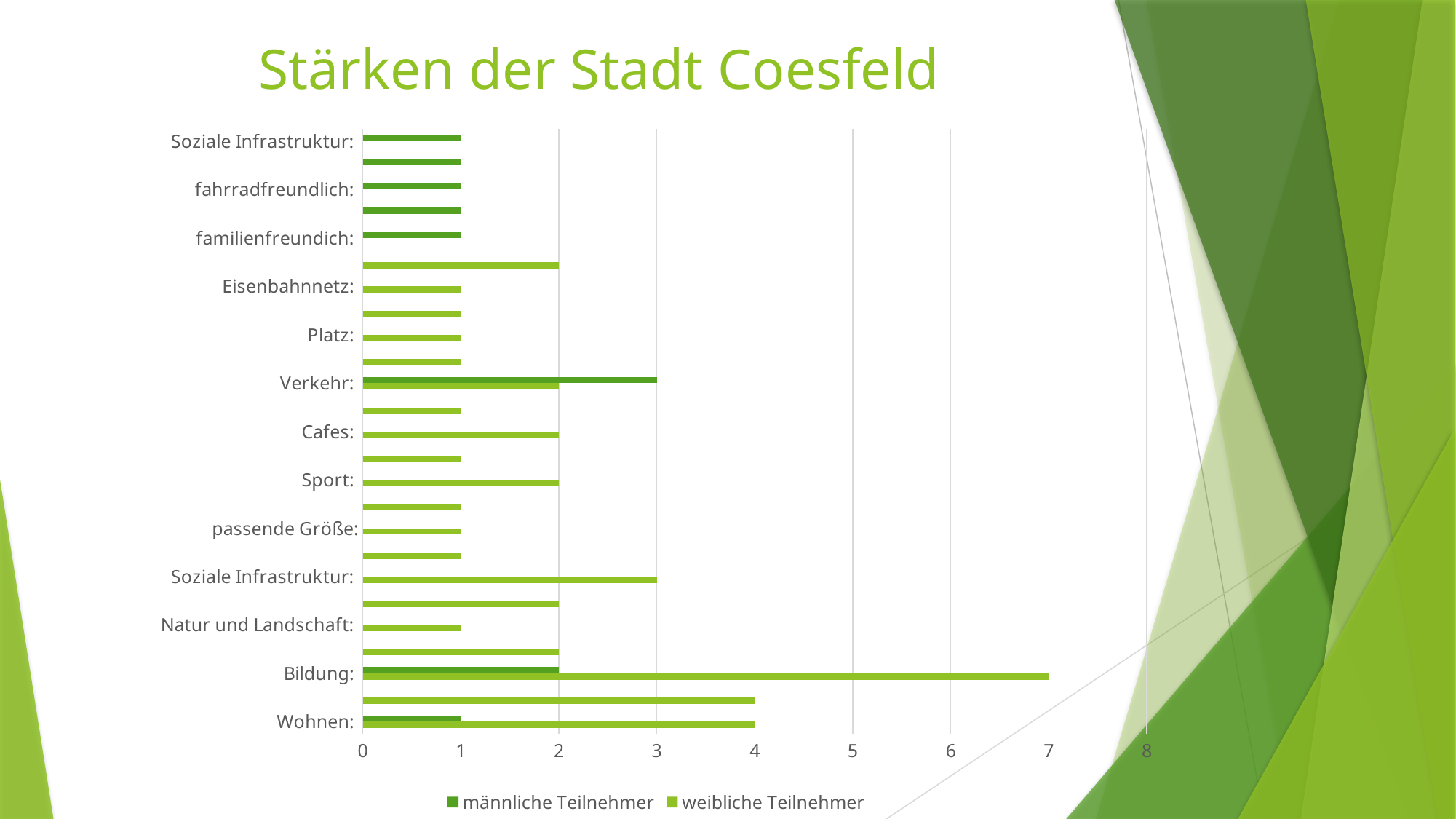
What is the title of the chart? Stärken der Stadt Coesfeld What is the value for männliche Teilnehmer for Verkehr? 3 What is the value for weibliche Teilnehmer for Bildung? 7 Which is larger: weibliche Teilnehmer for Bildung or weibliche Teilnehmer for Wohnen? Bildung Which category has the highest value for weibliche Teilnehmer? Bildung What are the two series named in the legend? männliche Teilnehmer, weibliche Teilnehmer What is the value for männliche Teilnehmer for Bildung? 2 Is the value for weibliche Teilnehmer for Bildung greater or less than 5? greater What kind of chart is shown on the slide? bar chart What is the value for weibliche Teilnehmer for Wohnen? 4 How many series does the legend list? 2 What is the difference between weibliche Teilnehmer and männliche Teilnehmer for Bildung? 5